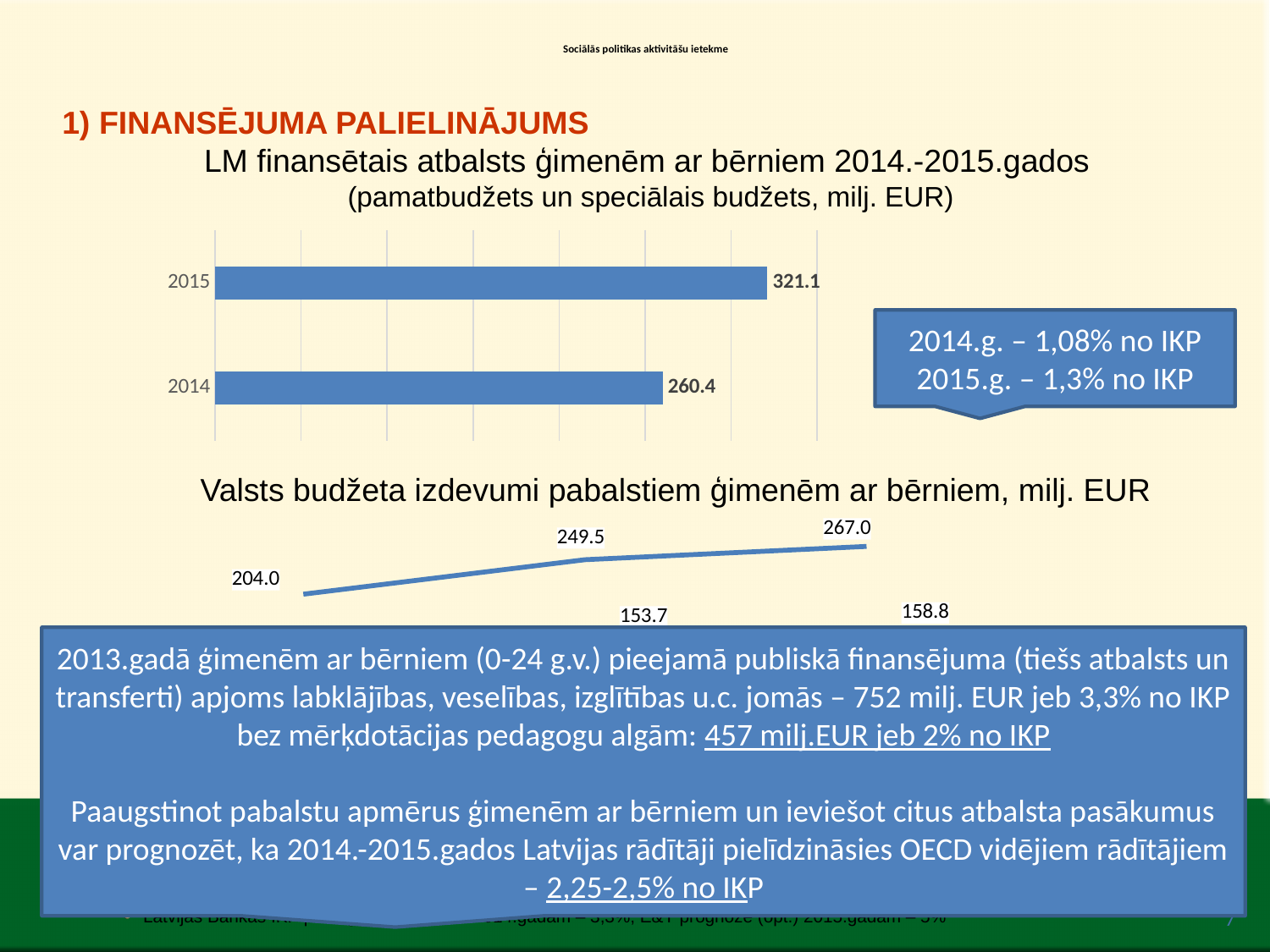
What type of chart is the upper chart titled 'LM finansētais atbalsts ģimenēm ar bērniem 2014.-2015.gados'? Bar chart How many bars are shown in the chart titled 'LM finansētais atbalsts ģimenēm ar bērniem 2014.-2015.gados'? 2 In the chart titled 'LM finansētais atbalsts ģimenēm ar bērniem 2014.-2015.gados', which year has the higher value? 2015 In the chart titled 'LM finansētais atbalsts ģimenēm ar bērniem 2014.-2015.gados', what is the value for 2015? 321.1 What unit is stated in the subtitle of the upper chart 'LM finansētais atbalsts ģimenēm ar bērniem 2014.-2015.gados'? milj. EUR In the chart titled 'LM finansētais atbalsts ģimenēm ar bērniem 2014.-2015.gados', what is the difference between the 2015 and 2014 values? 60.7 In the chart titled 'LM finansētais atbalsts ģimenēm ar bērniem 2014.-2015.gados', what is the value for 2014? 260.4 In the lower chart titled 'Valsts budžeta izdevumi pabalstiem ģimenēm ar bērniem, milj. EUR', does the upper line rise or fall from left to right? Rises What type of chart is the lower chart titled 'Valsts budžeta izdevumi pabalstiem ģimenēm ar bērniem, milj. EUR'? Line chart In the chart titled 'LM finansētais atbalsts ģimenēm ar bērniem 2014.-2015.gados', is the value for 2014 larger or smaller than the value for 2015? smaller In the lower chart titled 'Valsts budžeta izdevumi pabalstiem ģimenēm ar bērniem, milj. EUR', what is the highest data label shown on the upper line? 267.0 In the chart titled 'LM finansētais atbalsts ģimenēm ar bērniem 2014.-2015.gados', which year has the lower value? 2014